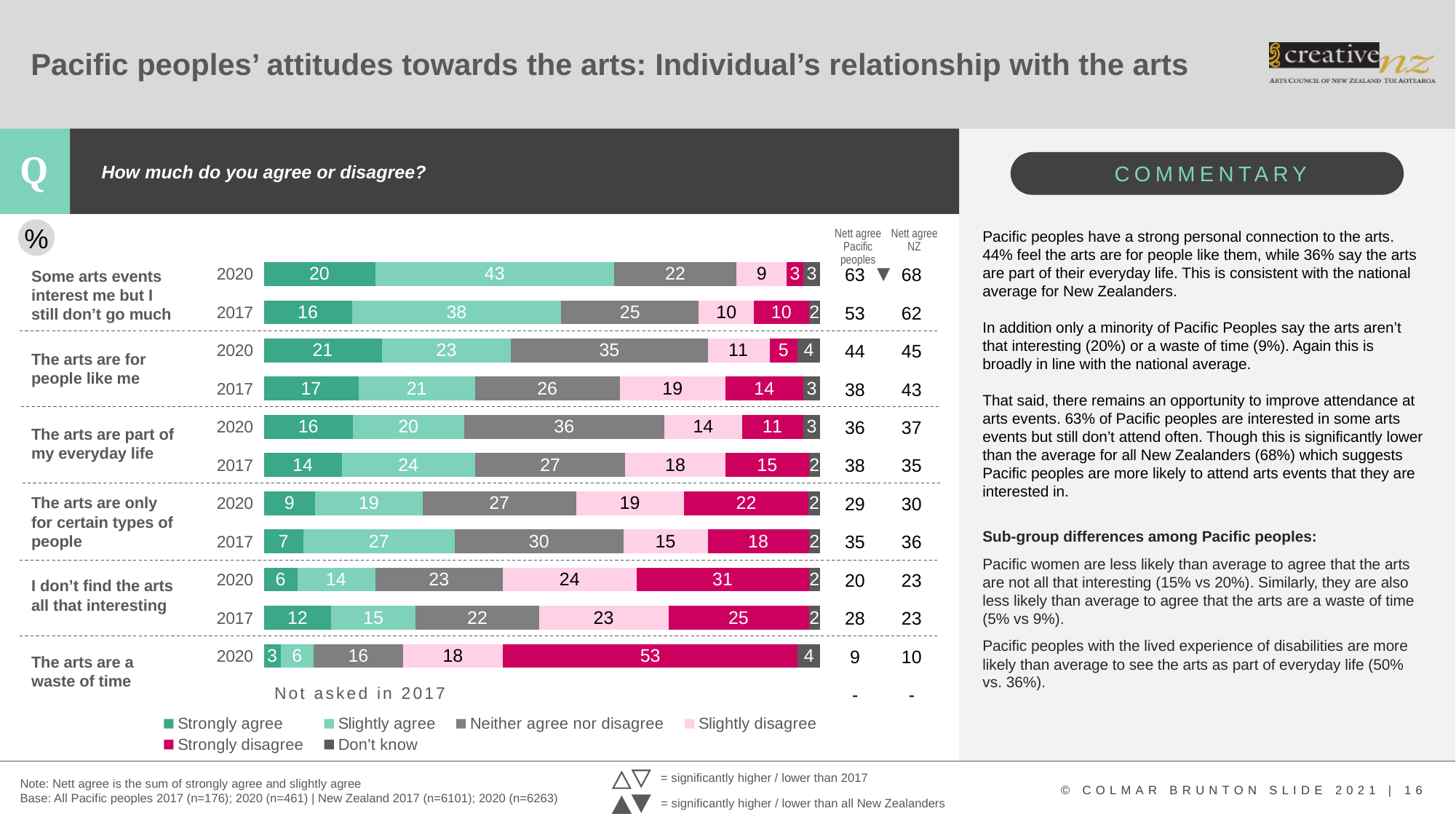
What is the Slightly disagree value for 'The arts are only for certain types of people' in 2017? 15 Which statement has the lowest Strongly agree value in 2020? The arts are a waste of time What is the Strongly disagree value for 'The arts are a waste of time' in 2020? 53 Did the Strongly agree value for 'I don't find the arts all that interesting' rise or fall from 2017 to 2020? Fall What is the Strongly agree value for 'The arts are for people like me' in 2020? 21 Which statement has the highest Strongly disagree value in 2020? The arts are a waste of time How many statements are shown in the chart? 6 What kind of chart is shown on the slide? Stacked bar chart For 'The arts are part of my everyday life', is the Neither agree nor disagree value larger in 2020 or 2017? 2020 What is the difference between the Slightly agree values for 'Some arts events interest me but I still don't go much' in 2020 and 2017? 5 How many series does the chart legend list? 6 What is the Nett agree Pacific peoples value for 'I don't find the arts all that interesting' in 2020? 20